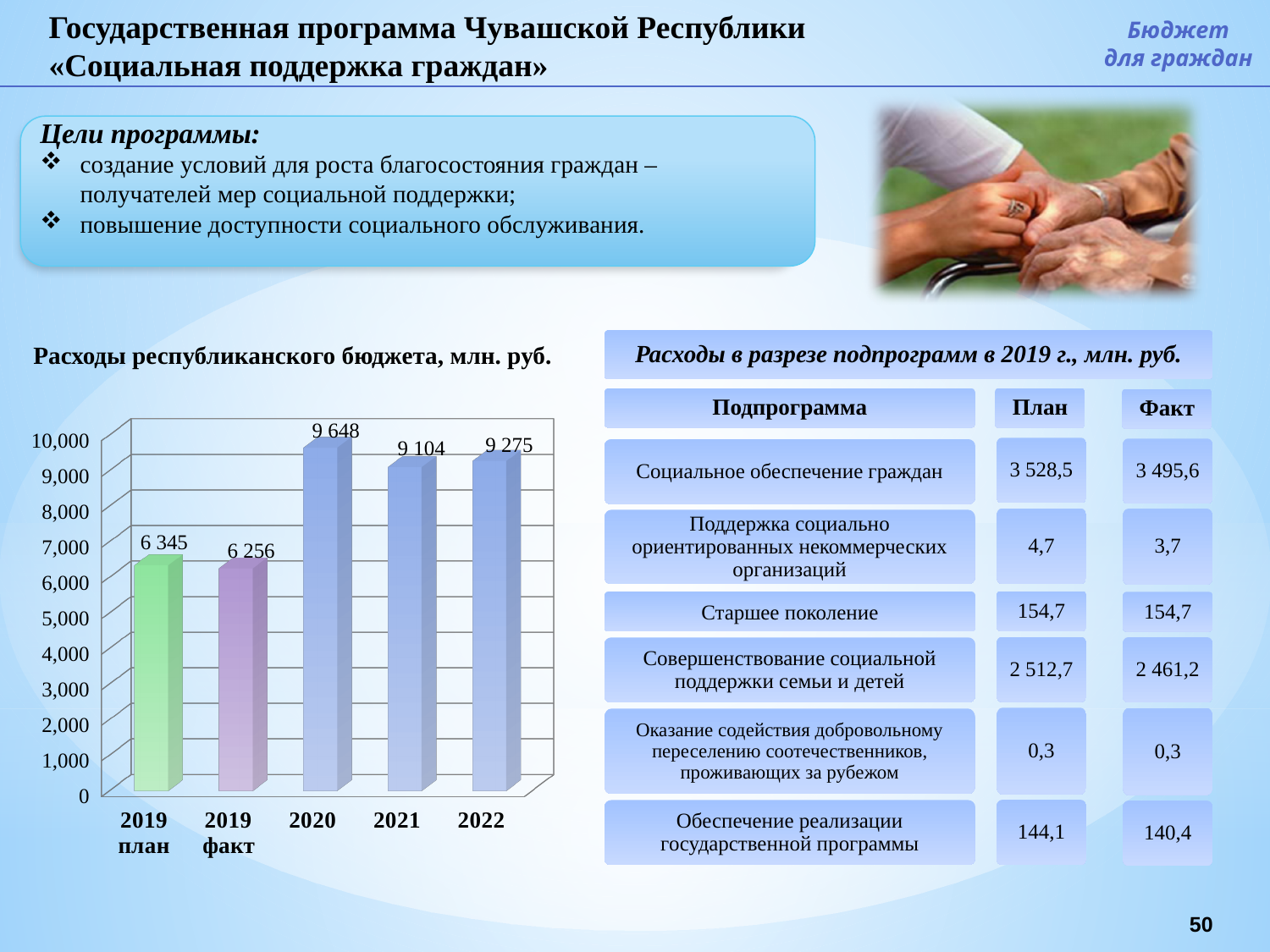
What is the value for '2019 план' in the chart? 6 345 Which is larger in the chart: the value for 2021 or the value for 2022? 2022 What is the value for 2022 in the chart? 9 275 Is the value for 2021 in the chart greater or less than 9,000? greater What type of chart is shown on the slide? bar chart What is the difference between '2019 план' and '2019 факт' in the chart? 89 Which category has the highest value in the chart? 2020 What is the value for 2020 in the chart 'Расходы республиканского бюджета, млн. руб.'? 9 648 How many bars are shown in the chart? 5 Which category has the lowest value in the chart? 2019 факт What is the difference between the values for 2020 and 2021 in the chart? 544 What is the value for '2019 факт' in the chart? 6 256